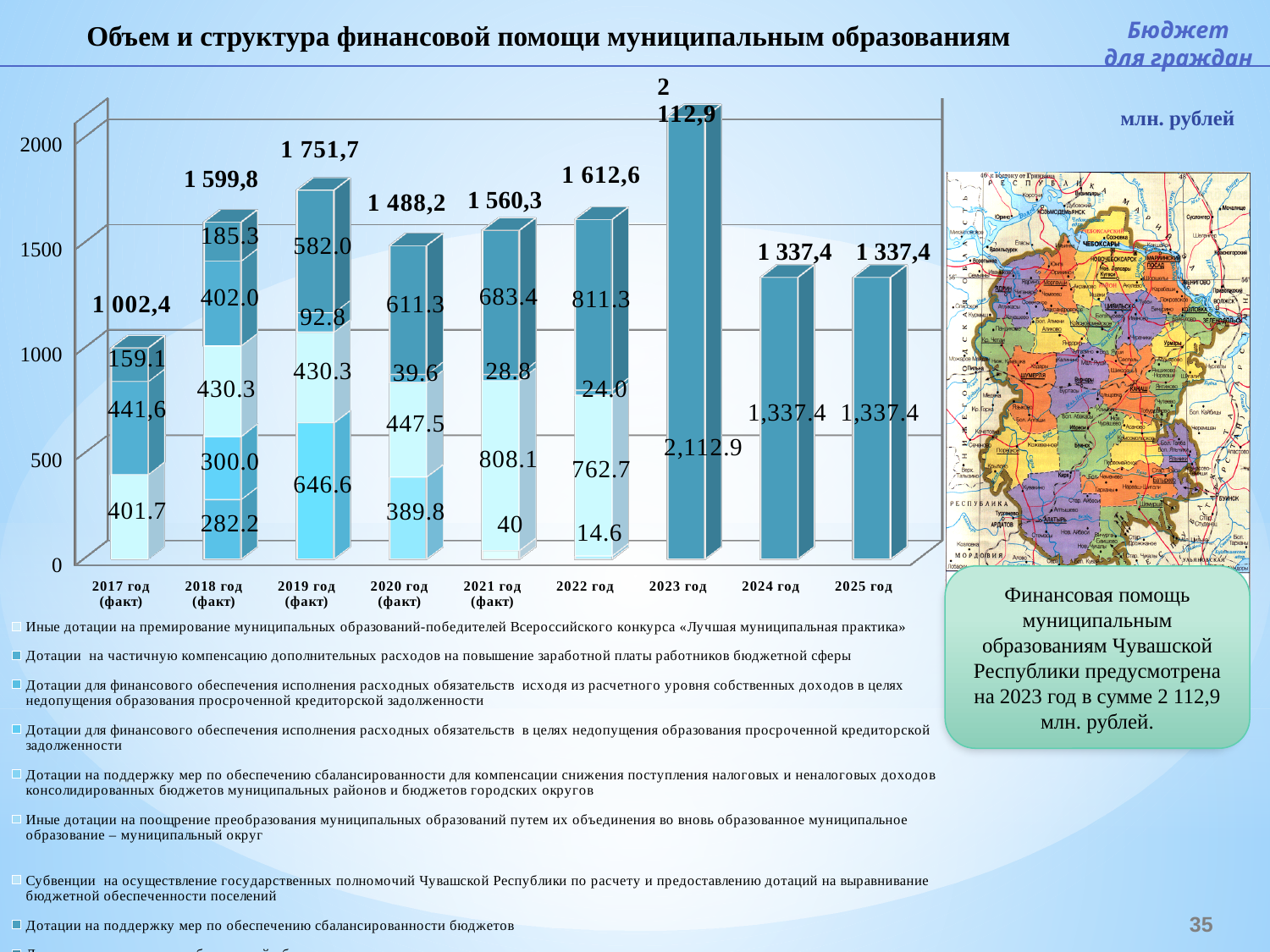
Which year has the lowest total financial assistance? 2017 год (факт) What kind of chart is shown on the slide? Stacked bar chart What is the difference between the totals for 2022 год and 2021 год? 52,3 What is the total value shown above the bar for 2023 год? 2 112,9 Which year has the larger total: 2018 год or 2019 год? 2019 год What is the difference between the totals for 2023 год and 2017 год? 1 110,5 In what units are the values on the chart expressed? млн. рублей Which year has the highest total financial assistance? 2023 год What is the total value shown for 2025 год? 1 337,4 How many years are shown on the x axis of the chart? 9 What is the value of the largest segment in the 2019 год bar? 646.6 Is the total for 2024 год greater or less than 1500? less